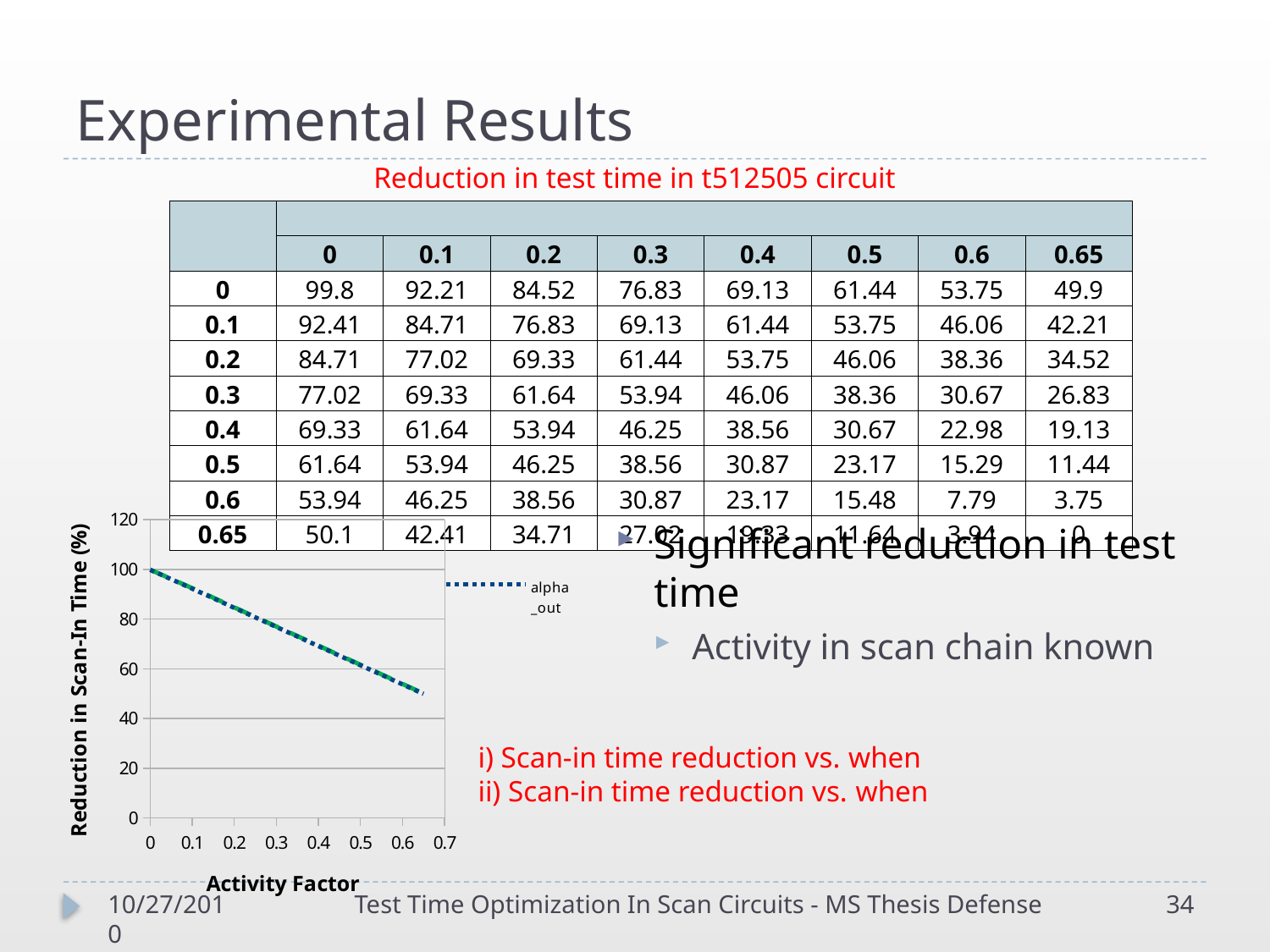
What is the highest tick value shown on the chart's vertical axis? 120 In the chart, is the value at Activity Factor 0.5 greater or less than 40? greater In the chart, is the value at Activity Factor 0 greater or less than 80? greater What is the title of the chart's vertical axis? Reduction in Scan-In Time (%) In the chart, is the value at Activity Factor 0.6 greater or less than 60? less What kind of chart is shown at the bottom left of the slide? line chart In the chart, which is larger: the value at Activity Factor 0.1 or the value at Activity Factor 0.5? 0.1 In the chart, at which Activity Factor is the reduction in scan-in time highest? 0 What is the title of the chart's horizontal axis? Activity Factor In the chart, do the values rise or fall as the Activity Factor increases? fall